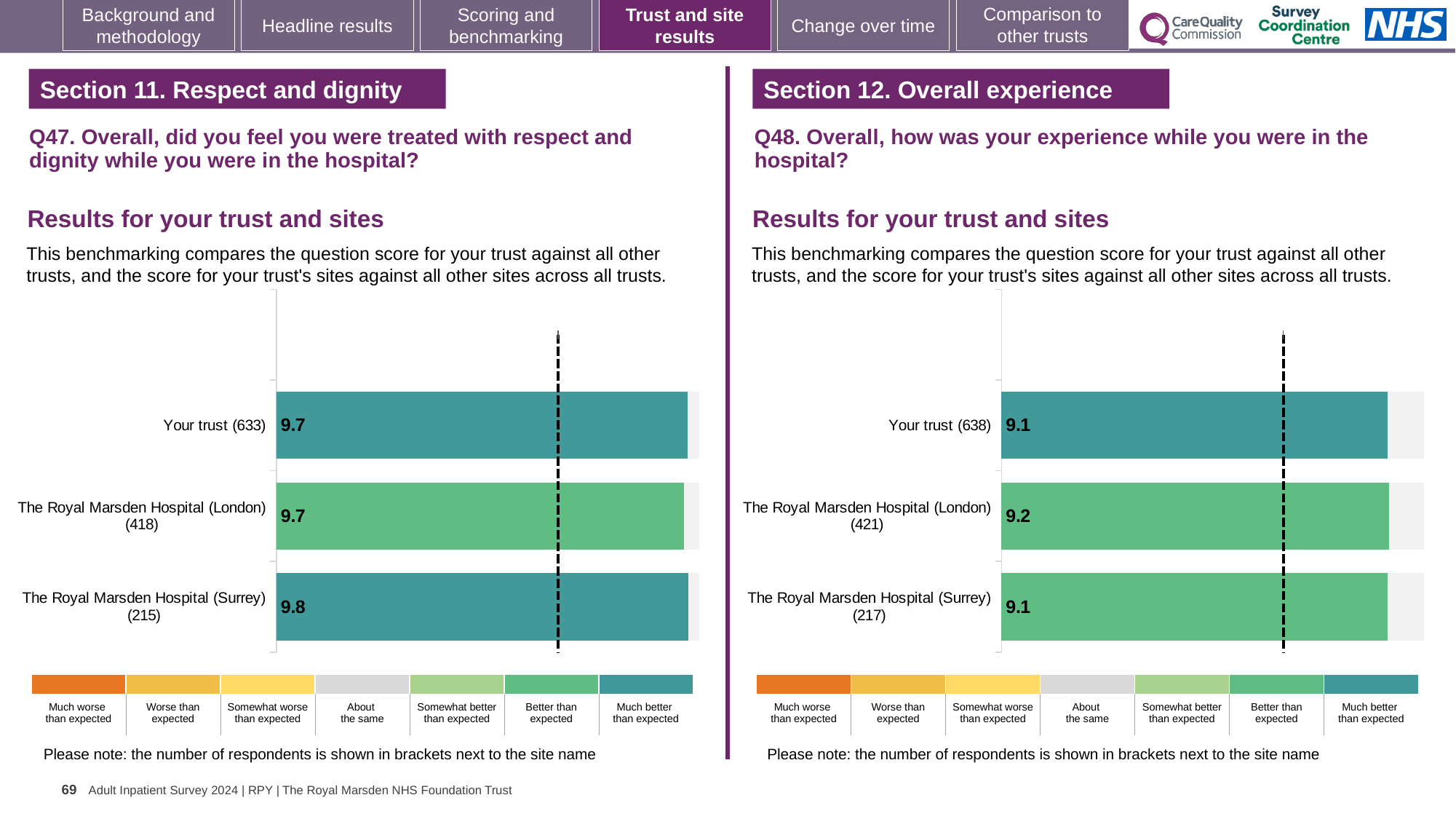
In the Q47 chart on the left, what is the difference between the score for The Royal Marsden Hospital (Surrey) and the score for Your trust? 0.1 What kind of chart is used in the Q48 chart on the right? bar chart In the Q47 chart on the left, what is the score for Your trust? 9.7 In the Q48 chart on the right, what is the score for Your trust? 9.1 In the Q48 chart on the right, which site or trust has the highest score? The Royal Marsden Hospital (London) In the Q48 chart on the right, what is the difference between the score for The Royal Marsden Hospital (London) and the score for Your trust? 0.1 In the Q48 chart on the right, what is the score for The Royal Marsden Hospital (London)? 9.2 In the Q48 chart on the right, is the score for The Royal Marsden Hospital (London) larger or smaller than the score for The Royal Marsden Hospital (Surrey)? larger In the Q47 chart on the left, what is the score for The Royal Marsden Hospital (Surrey)? 9.8 In the Q47 chart on the left, which site or trust has the highest score? The Royal Marsden Hospital (Surrey) How many bars are plotted in the Q47 chart on the left? 3 In the Q47 chart on the left, how many respondents are shown in brackets for Your trust? 633